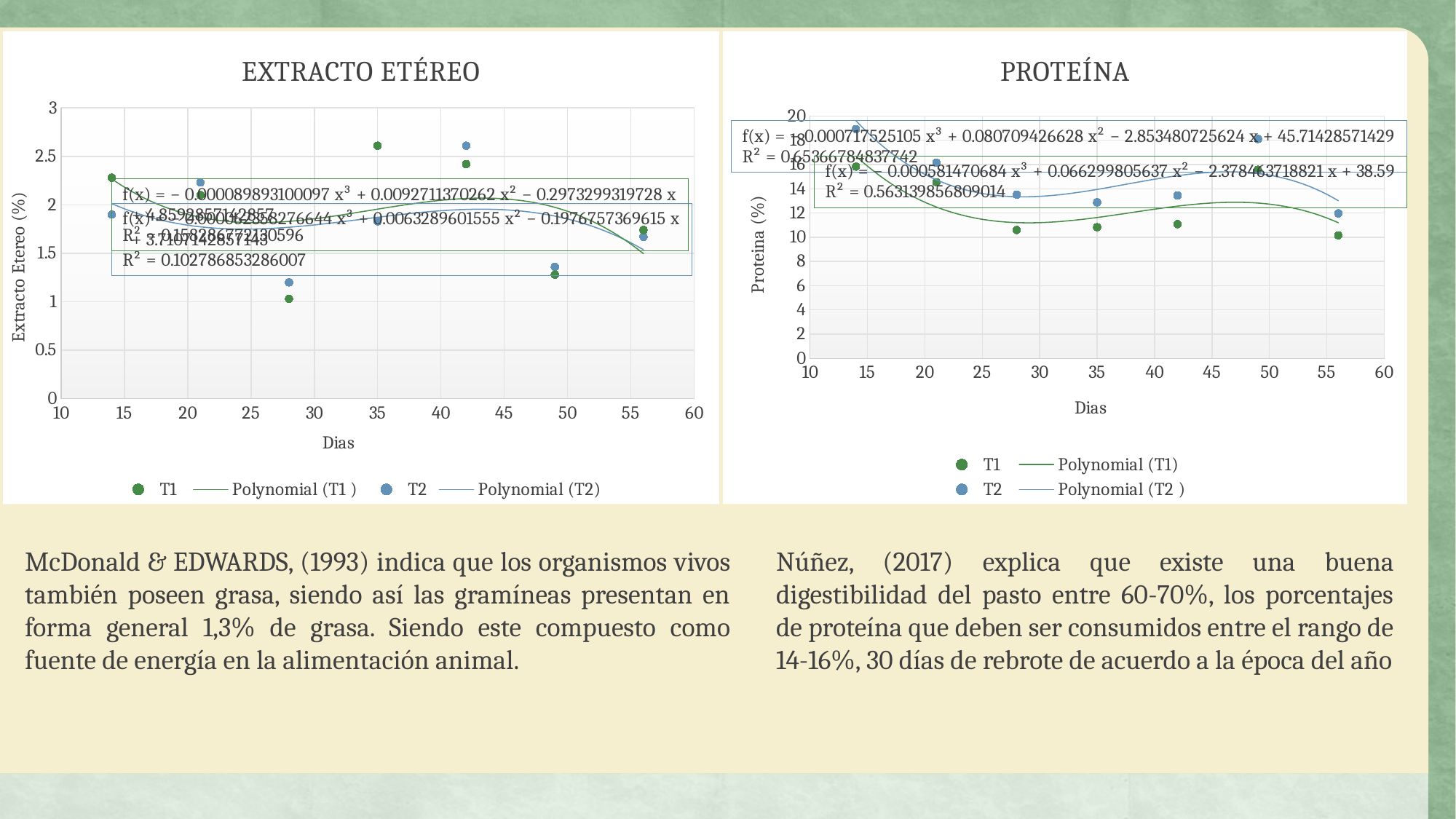
In the EXTRACTO ETÉREO chart, is the T1 value at 28 days greater or less than 1.5? less In the EXTRACTO ETÉREO chart, is the T1 value at 35 days greater or less than 2? greater What is the title of the left chart on the slide? EXTRACTO ETÉREO In the PROTEÍNA chart, at 28 days, which series has the larger value, T1 or T2? T2 In the PROTEÍNA chart, at how many days does the T2 series reach its highest value? 14 In the EXTRACTO ETÉREO chart, how many T1 data points are plotted? 7 In the EXTRACTO ETÉREO chart, at how many days does the T1 series reach its lowest value? 28 What kind of chart is the EXTRACTO ETÉREO chart? scatter chart How many entries does the legend of the PROTEÍNA chart list? 4 In the PROTEÍNA chart, is the T2 value at 14 days greater or less than 16? greater What is the label of the x axis on the PROTEÍNA chart? Dias